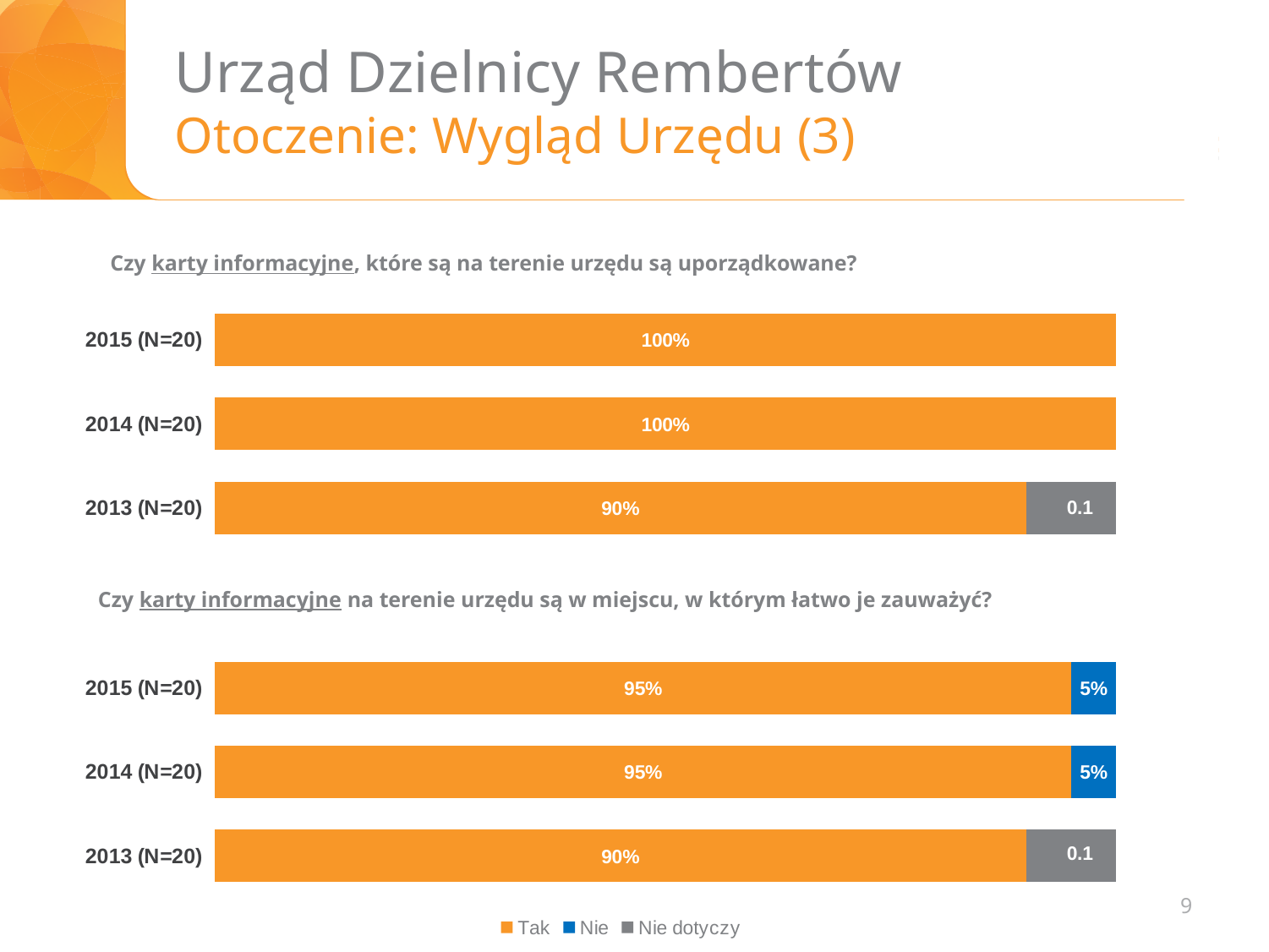
In the top chart, what is the 'Tak' value for 2013 (N=20)? 90% In the top chart, what value is shown for the grey 'Nie dotyczy' segment for 2013 (N=20)? 0.1 How many year categories does the bottom chart show? 3 In the bottom chart, what is the 'Nie' value for 2015 (N=20)? 5% In the bottom chart, what is the 'Tak' value for 2014 (N=20)? 95% In the bottom chart, is the 'Tak' value for 2015 (N=20) larger or smaller than the 'Tak' value for 2013 (N=20)? larger How many series does the legend at the bottom of the slide list? 3 What type of chart is the top chart? Stacked bar chart In the bottom chart, which year has the lowest 'Tak' value? 2013 (N=20) In the top chart, what is the difference between the 'Tak' value for 2014 (N=20) and for 2013 (N=20)? 10% What are the legend entries shown at the bottom of the slide? Tak, Nie, Nie dotyczy In the top chart, what is the 'Tak' value for 2015 (N=20)? 100%